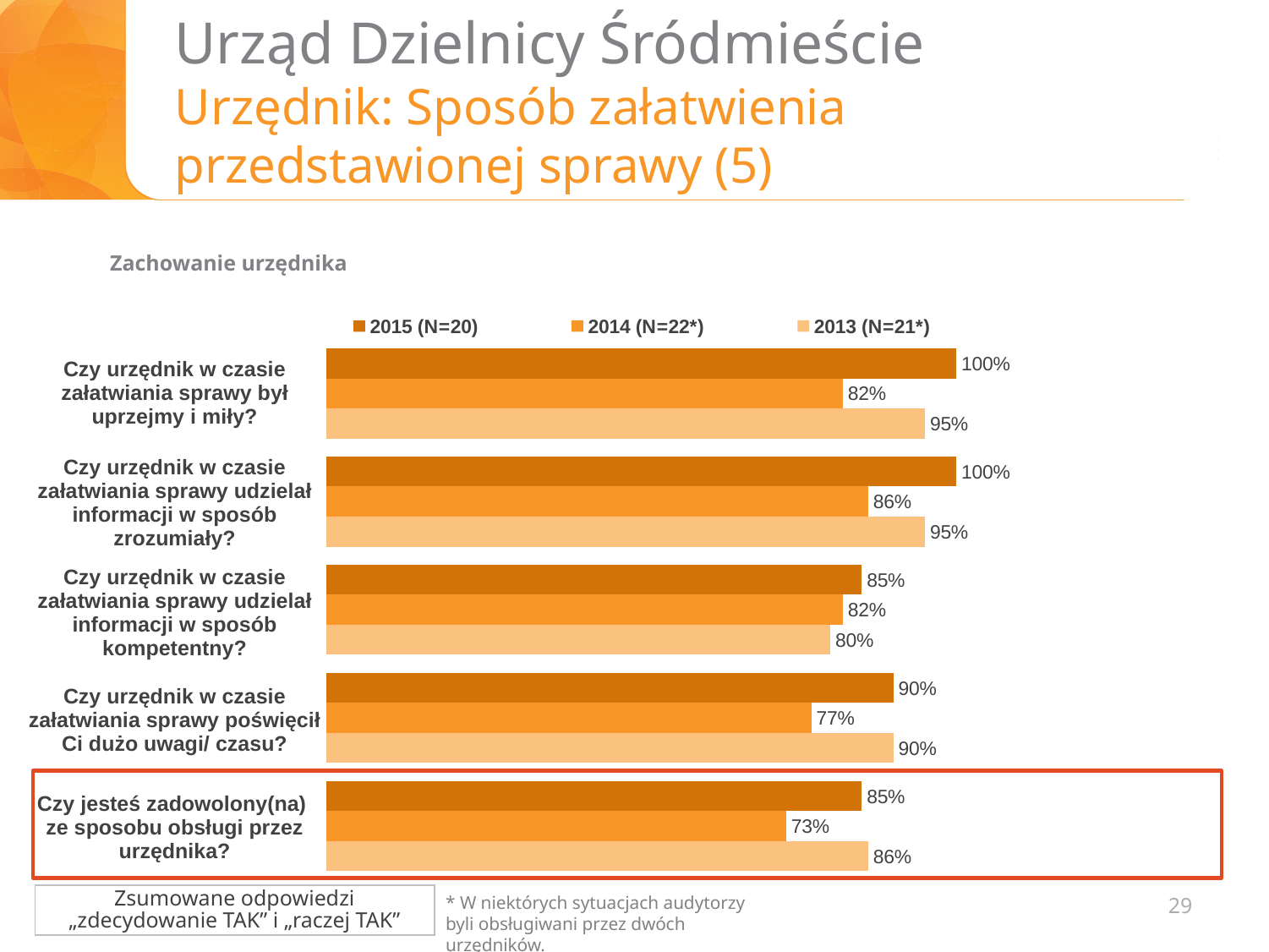
How many series does the legend list? 3 What is the difference between the 2015 (N=20) and 2014 (N=22*) values for "Czy urzędnik w czasie załatwiania sprawy był uprzejmy i miły?"? 18% What is the 2014 (N=22*) value for "Czy urzędnik w czasie załatwiania sprawy poświęcił Ci dużo uwagi/ czasu?"? 77% What is the 2015 (N=20) value for "Czy urzędnik w czasie załatwiania sprawy udzielał informacji w sposób zrozumiały?"? 100% Which category has the lowest 2014 (N=22*) value? Czy jesteś zadowolony(na) ze sposobu obsługi przez urzędnika? How many question categories are shown in the chart? 5 What is the 2015 (N=20) value for "Czy jesteś zadowolony(na) ze sposobu obsługi przez urzędnika?"? 85% What is the subtitle printed above the chart? Zachowanie urzędnika Which category has the lowest 2013 (N=21*) value? Czy urzędnik w czasie załatwiania sprawy udzielał informacji w sposób kompetentny? For "Czy jesteś zadowolony(na) ze sposobu obsługi przez urzędnika?", which is larger: the 2013 (N=21*) value or the 2014 (N=22*) value? 2013 (N=21*) What kind of chart is shown on the slide? Bar chart What is the 2013 (N=21*) value for "Czy urzędnik w czasie załatwiania sprawy udzielał informacji w sposób kompetentny?"? 80%